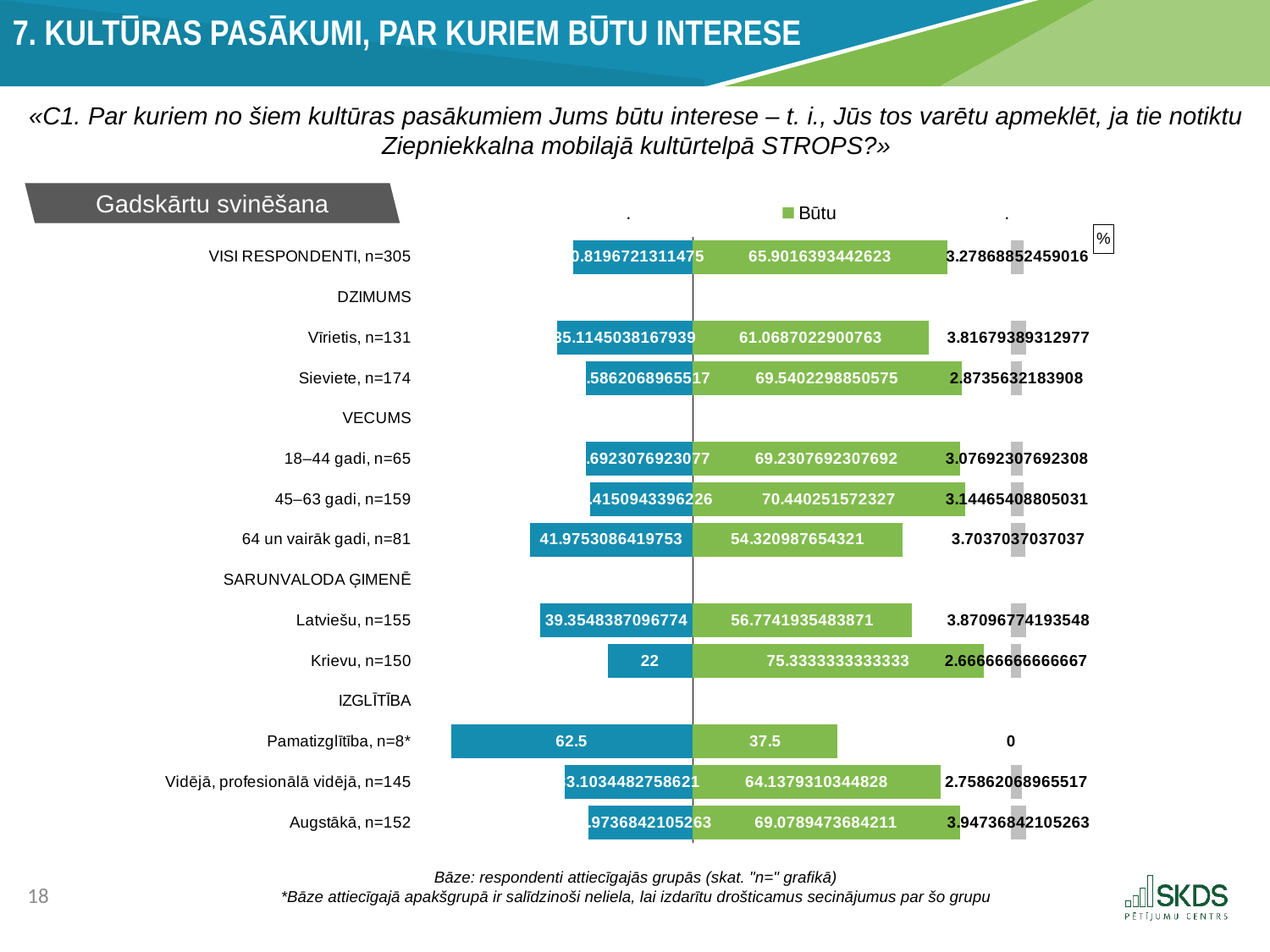
What is the value of the grey (right) segment for Augstākā, n=152? 3.94736842105263 What is the 'Būtu' value for VISI RESPONDENTI, n=305? 65.9016393442623 Which group has the lowest 'Būtu' value? Pamatizglītība, n=8* What is the 'Būtu' value for Krievu, n=150? 75.3333333333333 What is the value of the blue (left) segment for Pamatizglītība, n=8*? 62.5 What kind of chart is shown on the slide? Bar chart Which has a larger 'Būtu' value: Latviešu, n=155 or Krievu, n=150? Krievu, n=150 How many series does the legend list? 3 Which group has the highest 'Būtu' value? Krievu, n=150 What is the total of the three segments for Krievu, n=150? 100 What is the title shown in the box above the chart? Gadskārtu svinēšana What is the difference between the 'Būtu' value for Pamatizglītība, n=8* and the blue segment value for the same group? 25